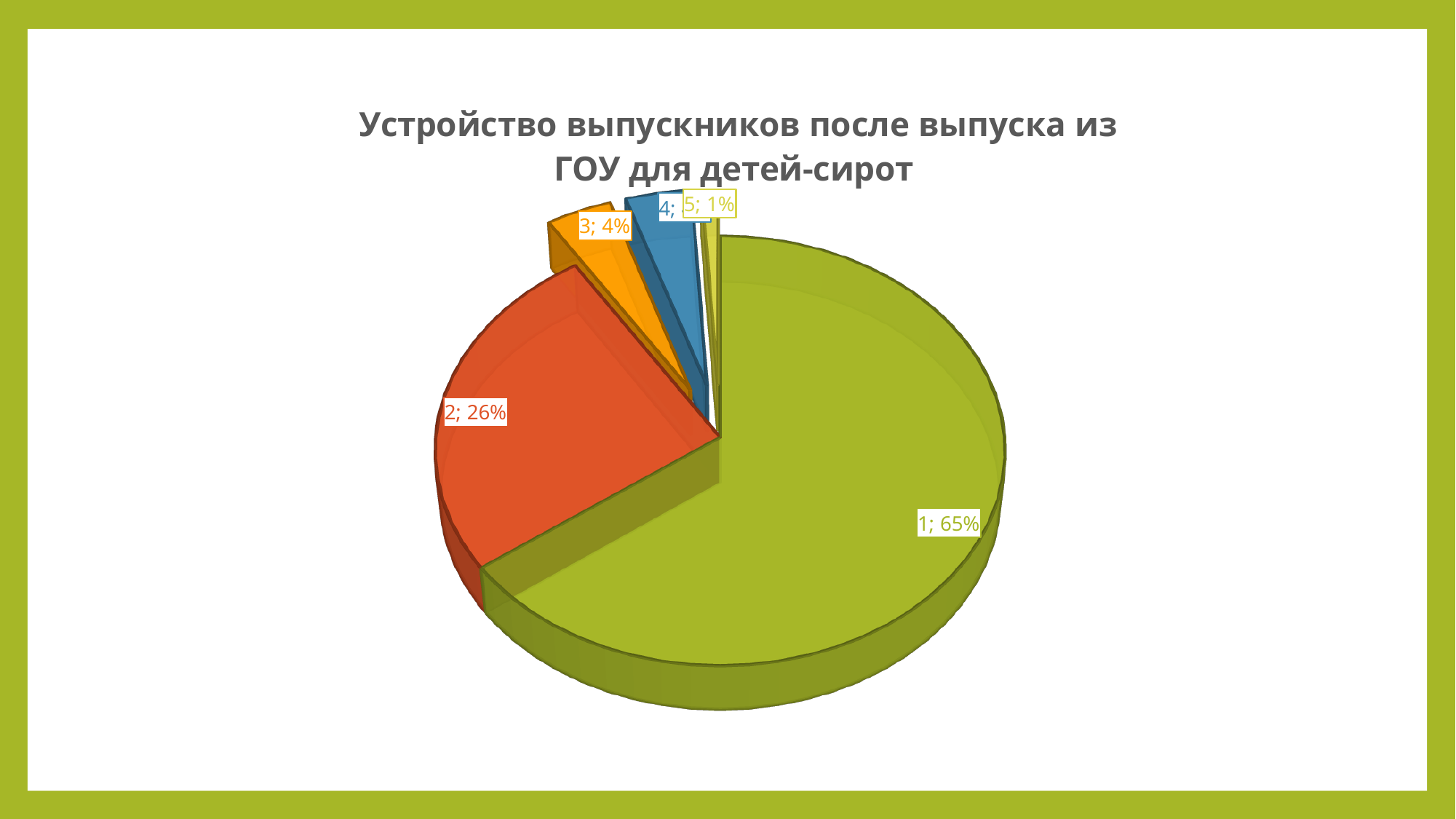
What is the title of the chart? Устройство выпускников после выпуска из ГОУ для детей-сирот Which is larger, slice 2 or slice 3? slice 2 How many slices does the pie chart have? 5 What percentage is shown for slice 3? 4% What kind of chart is shown on the slide? pie chart What percentage is shown for slice 1? 65% What percentage is shown for slice 2? 26% What percentage is shown for slice 5? 1% Which slice has the largest share of the pie? 1 Which slice has the smallest share of the pie? 5 What is the difference in percentage points between slice 1 and slice 2? 39 What colour is the largest slice of the pie? green